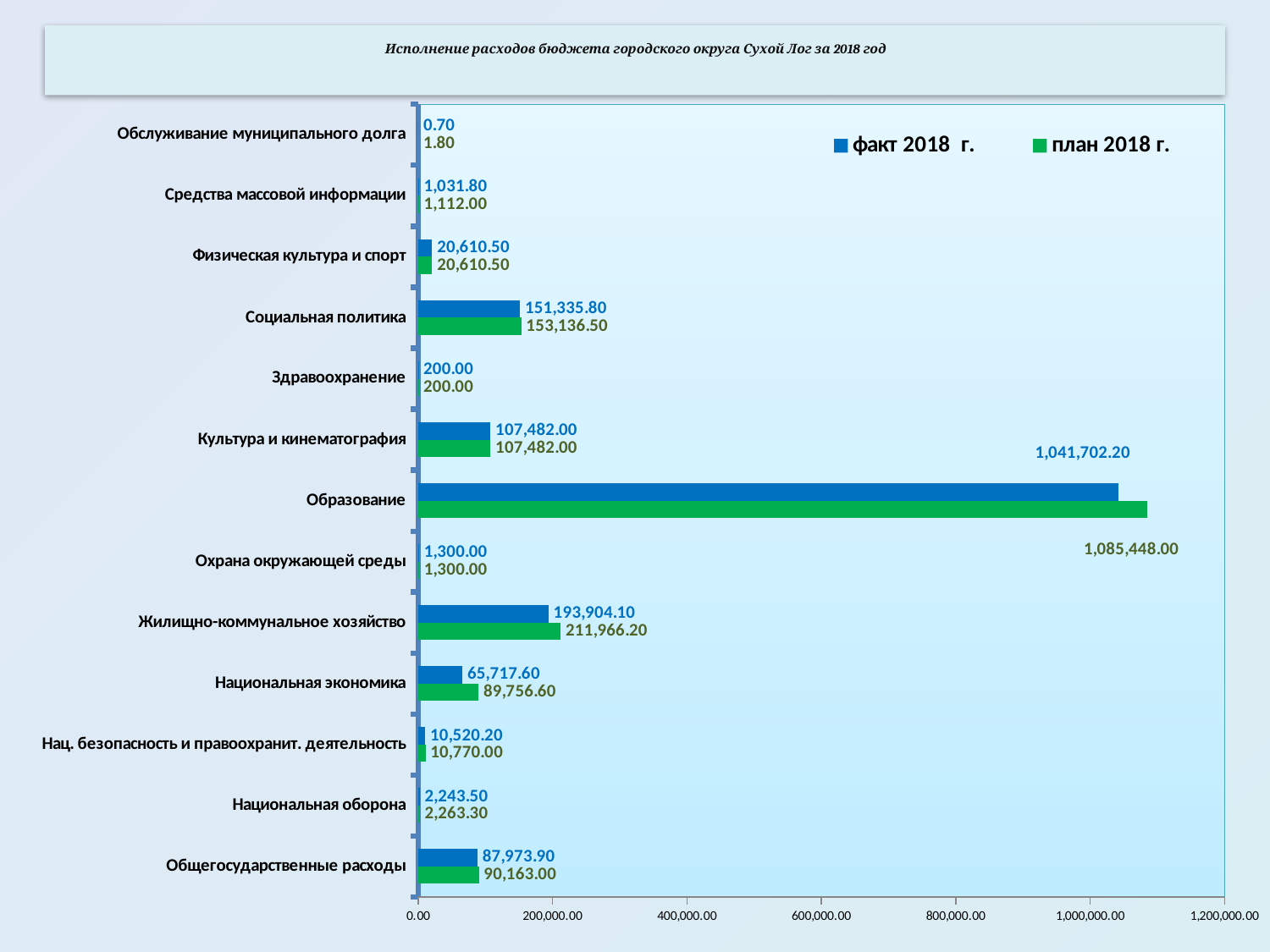
What is the difference between the план 2018 г. and факт 2018 г. values for Образование? 43,745.80 What is the план 2018 г. value for Жилищно-коммунальное хозяйство? 211,966.20 What is the difference between the план 2018 г. and факт 2018 г. values for Национальная экономика? 24,039.00 What is the факт 2018 г. value for Образование? 1,041,702.20 How many series does the legend list? 2 What is the факт 2018 г. value for Национальная экономика? 65,717.60 What type of chart is shown on the slide? bar chart Which is larger for Социальная политика: the факт 2018 г. value or the план 2018 г. value? план 2018 г. Which category has the highest план 2018 г. value? Образование How many categories are shown on the chart? 13 Which category has the lowest факт 2018 г. value? Обслуживание муниципального долга Which colour represents the факт 2018 г. series? blue